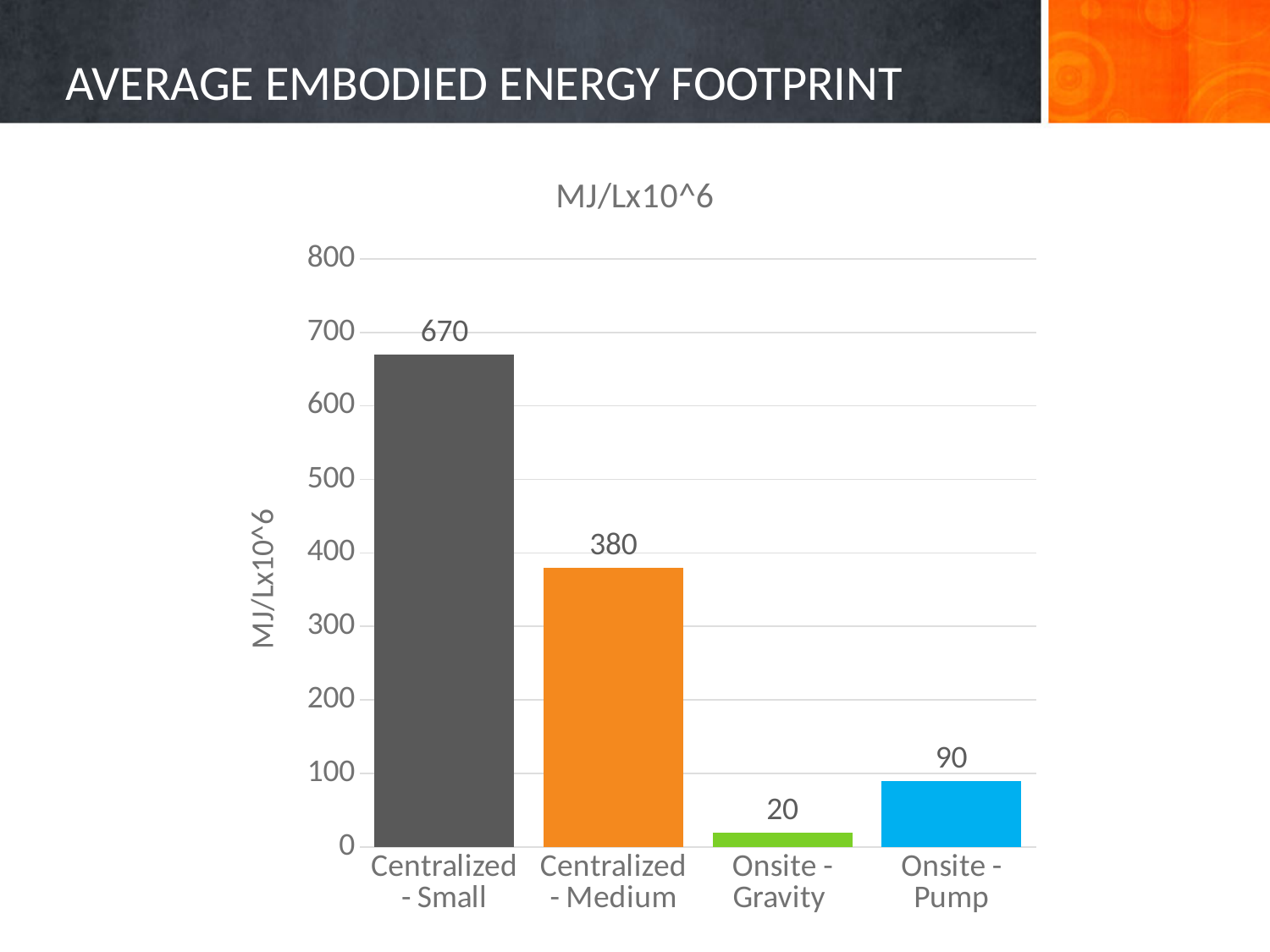
What is the title of the chart? MJ/Lx10^6 What is the value for Onsite - Pump? 90 What is the difference between the values for Onsite - Pump and Onsite - Gravity? 70 How many categories are shown in the chart? 4 Which category has the lowest value? Onsite - Gravity Which is larger, the value for Onsite - Pump or the value for Onsite - Gravity? Onsite - Pump What is the difference between the values for Centralized - Small and Centralized - Medium? 290 What is the value for Onsite - Gravity? 20 What is the value for Centralized - Small? 670 What kind of chart is shown on the slide? Bar chart What is the value for Centralized - Medium? 380 Which category has the highest value? Centralized - Small